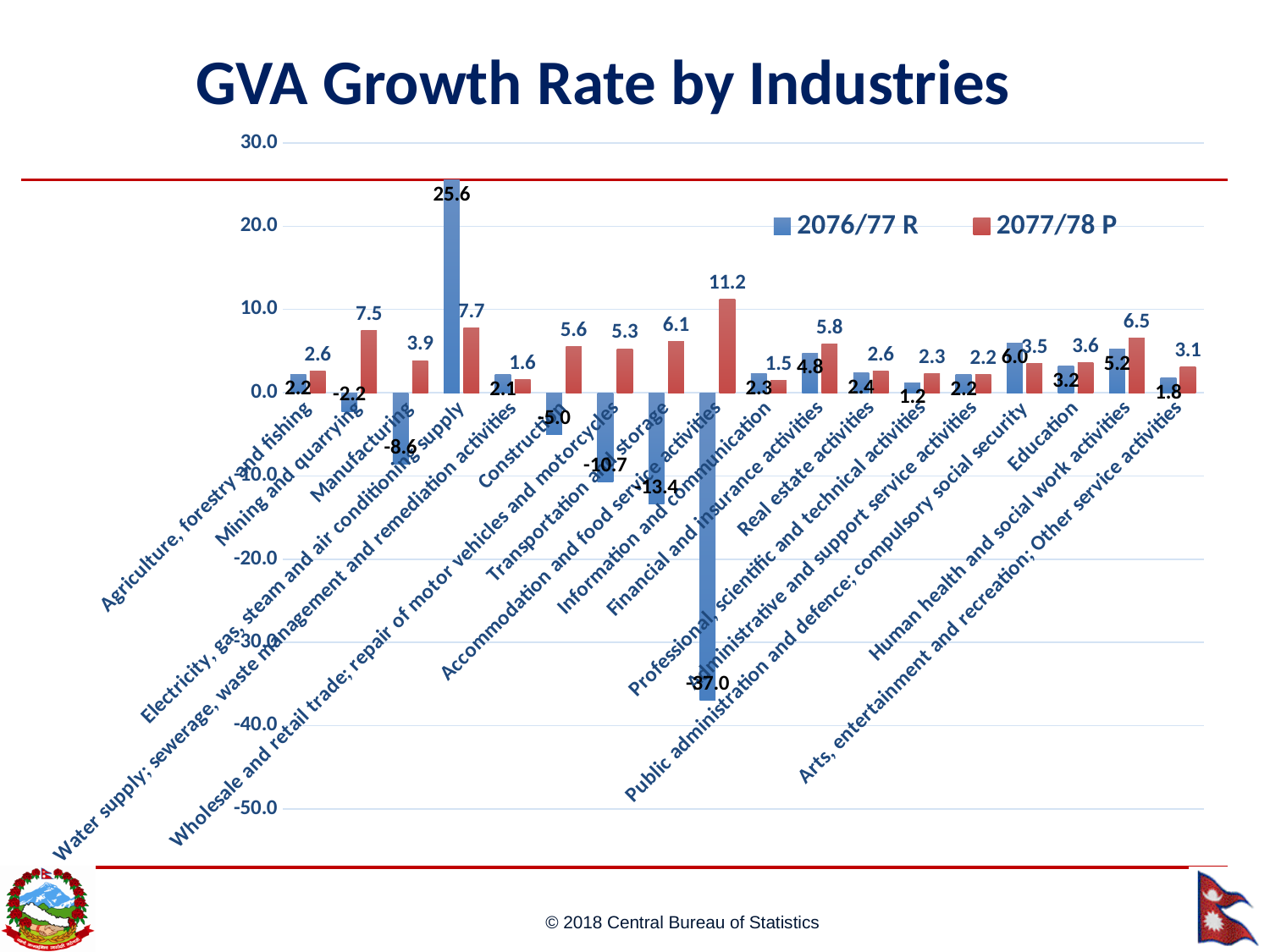
What is the GVA growth rate for Electricity, gas, steam and air conditioning supply in 2076/77 R? 25.6 What is the 2076/77 R value for Accommodation and food service activities? -37.0 What is the difference between the 2077/78 P and 2076/77 R values for Mining and quarrying? 9.7 What is the title of the chart? GVA Growth Rate by Industries Which industry has the lowest 2076/77 R growth rate? Accommodation and food service activities What kind of chart is shown on the slide? Bar chart What is the 2077/78 P value for Financial and insurance activities? 5.8 For Human health and social work activities, which series has the larger value, 2076/77 R or 2077/78 P? 2077/78 P What is the GVA growth rate for Accommodation and food service activities in 2077/78 P? 11.2 Is the 2076/77 R value for Transportation and storage greater or less than -10.0? less Which industry has the highest 2077/78 P growth rate? Accommodation and food service activities How many series does the legend list? 2